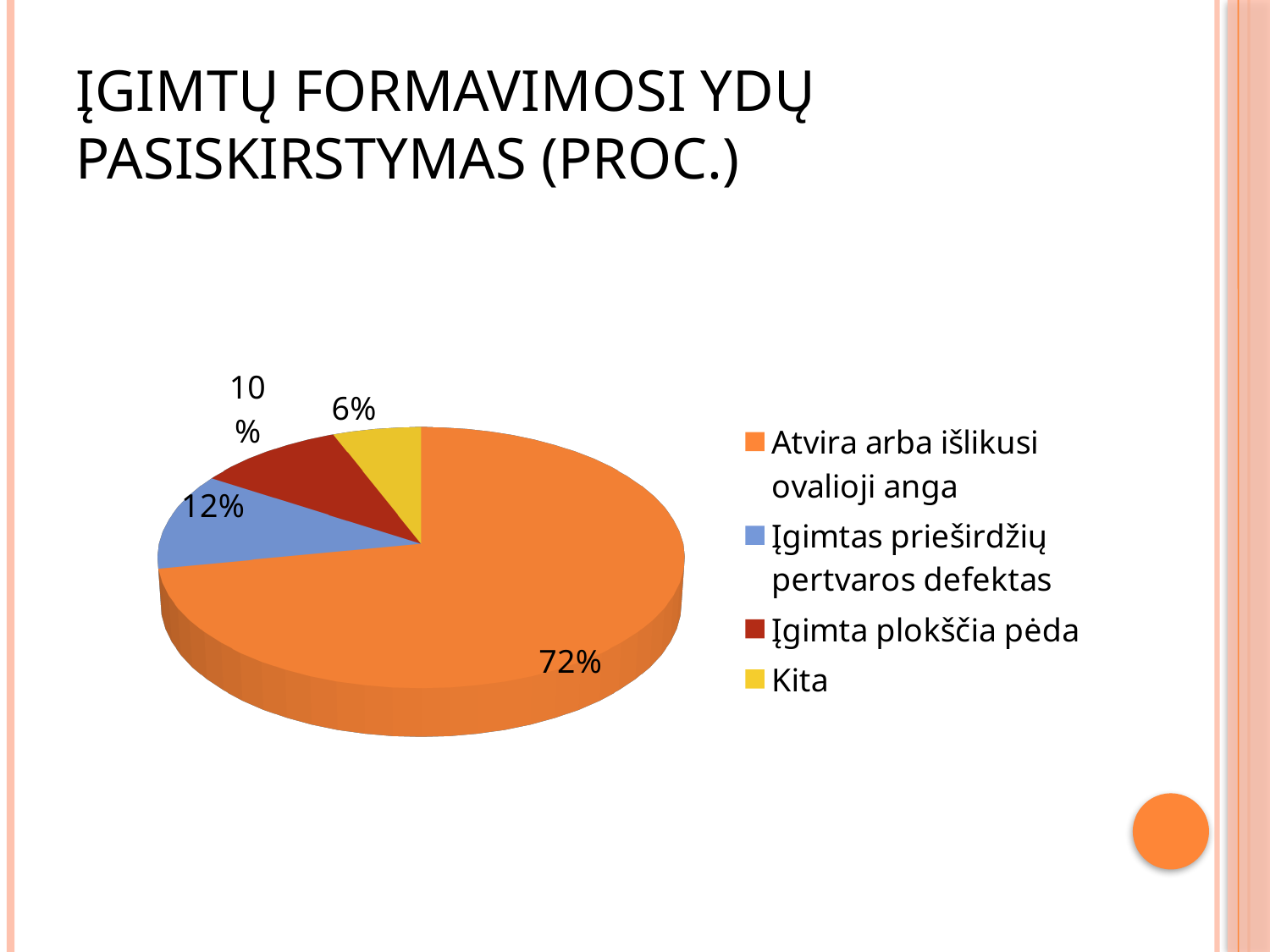
What is the difference in percentage points between "Atvira arba išlikusi ovalioji anga" and "Įgimtas prieširdžių pertvaros defektas"? 60 What colour is the slice for "Kita"? Yellow What share of the pie does "Įgimtas prieširdžių pertvaros defektas" represent? 12% What kind of chart is shown on the slide? Pie chart What share of the pie does "Įgimta plokščia pėda" represent? 10% Which category has the largest slice of the pie? Atvira arba išlikusi ovalioji anga What share of the pie does "Kita" represent? 6% Which category has the smallest slice of the pie? Kita Which is larger: the slice for "Įgimta plokščia pėda" or the slice for "Kita"? Įgimta plokščia pėda How many categories does the pie chart show? 4 What share of the pie does "Atvira arba išlikusi ovalioji anga" represent? 72% What is the title of the slide containing the chart? Įgimtų formavimosi ydų pasiskirstymas (proc.)